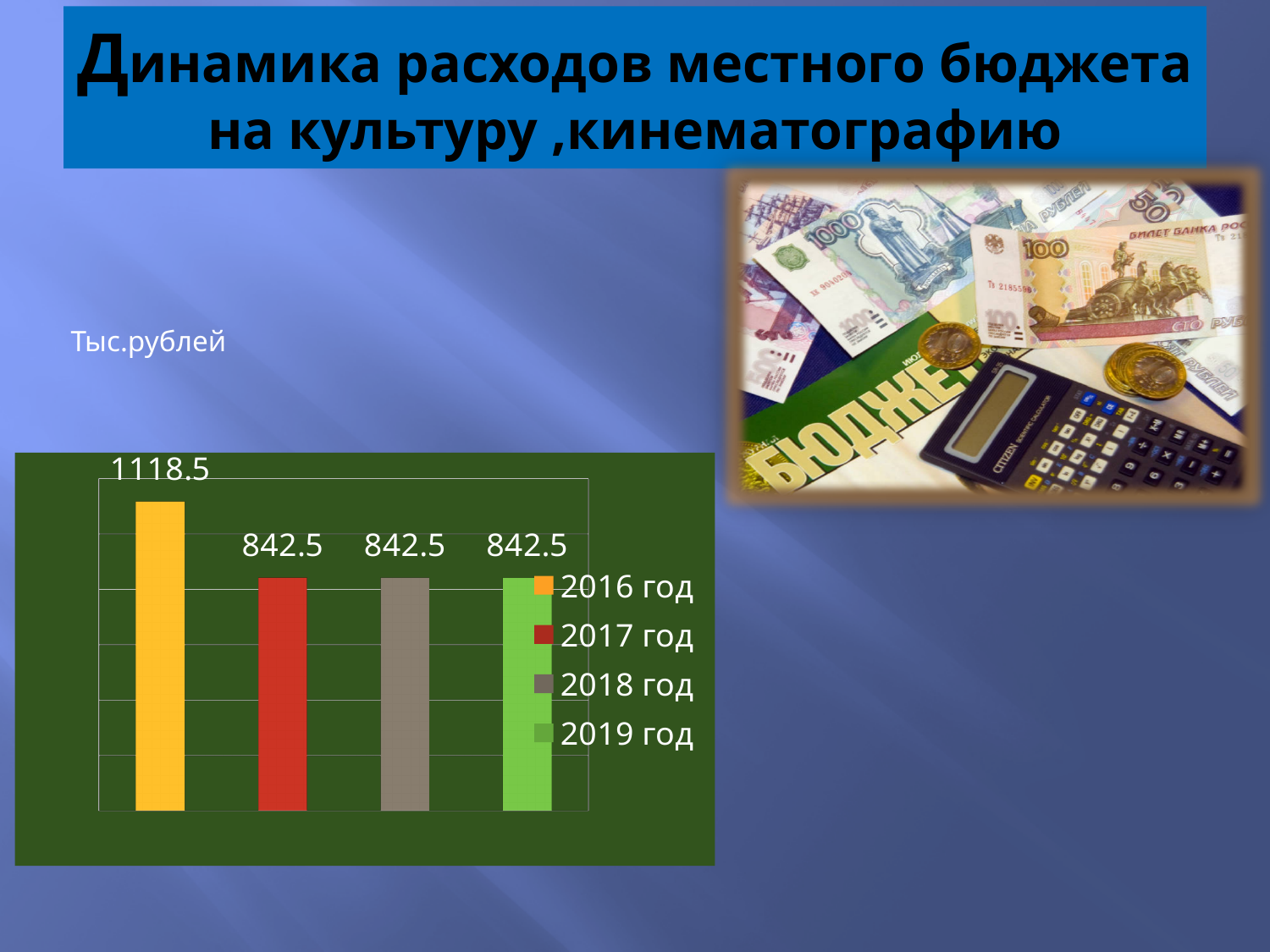
What is the value for 2017 год? 842.5 How many entries does the legend list? 4 What kind of chart is shown on the slide? bar chart Do the values rise or fall from 2016 год to 2017 год? fall What colour is the bar for 2017 год? red What unit is stated above the chart? Тыс.рублей How many bars are plotted in the chart? 4 Which is larger, the value for 2016 год or the value for 2018 год? 2016 год Which year has the highest value? 2016 год What is the value for 2019 год? 842.5 What is the difference between the values for 2016 год and 2017 год? 276 What is the value for 2016 год? 1118.5